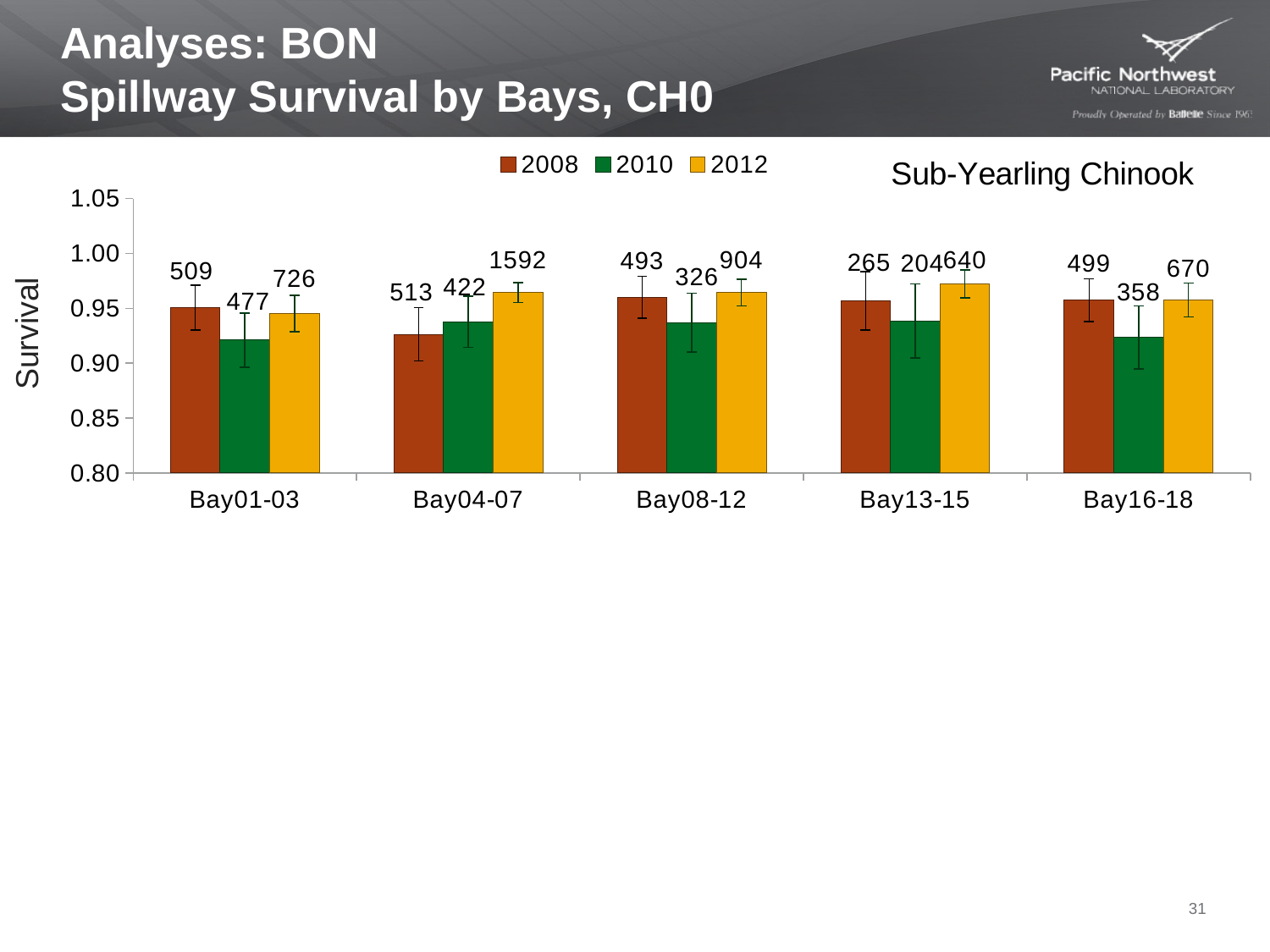
How many bay groups are shown on the x axis? 5 For Bay01-03, which year has the higher survival, 2008 or 2010? 2008 How many series does the legend list? 3 For Bay04-07, which year has the higher survival, 2008 or 2012? 2012 Which years are listed in the legend? 2008, 2010, 2012 What kind of chart is shown on the slide? bar chart Is the 2008 survival value for Bay04-07 greater or less than 0.95? less For Bay16-18, which year has the lowest survival? 2010 Is the 2012 survival value for Bay13-15 greater or less than 0.95? greater Is the 2010 survival value for Bay01-03 greater or less than 0.90? greater For Bay04-07, which year has the lowest survival? 2008 What is the label on the y axis? Survival